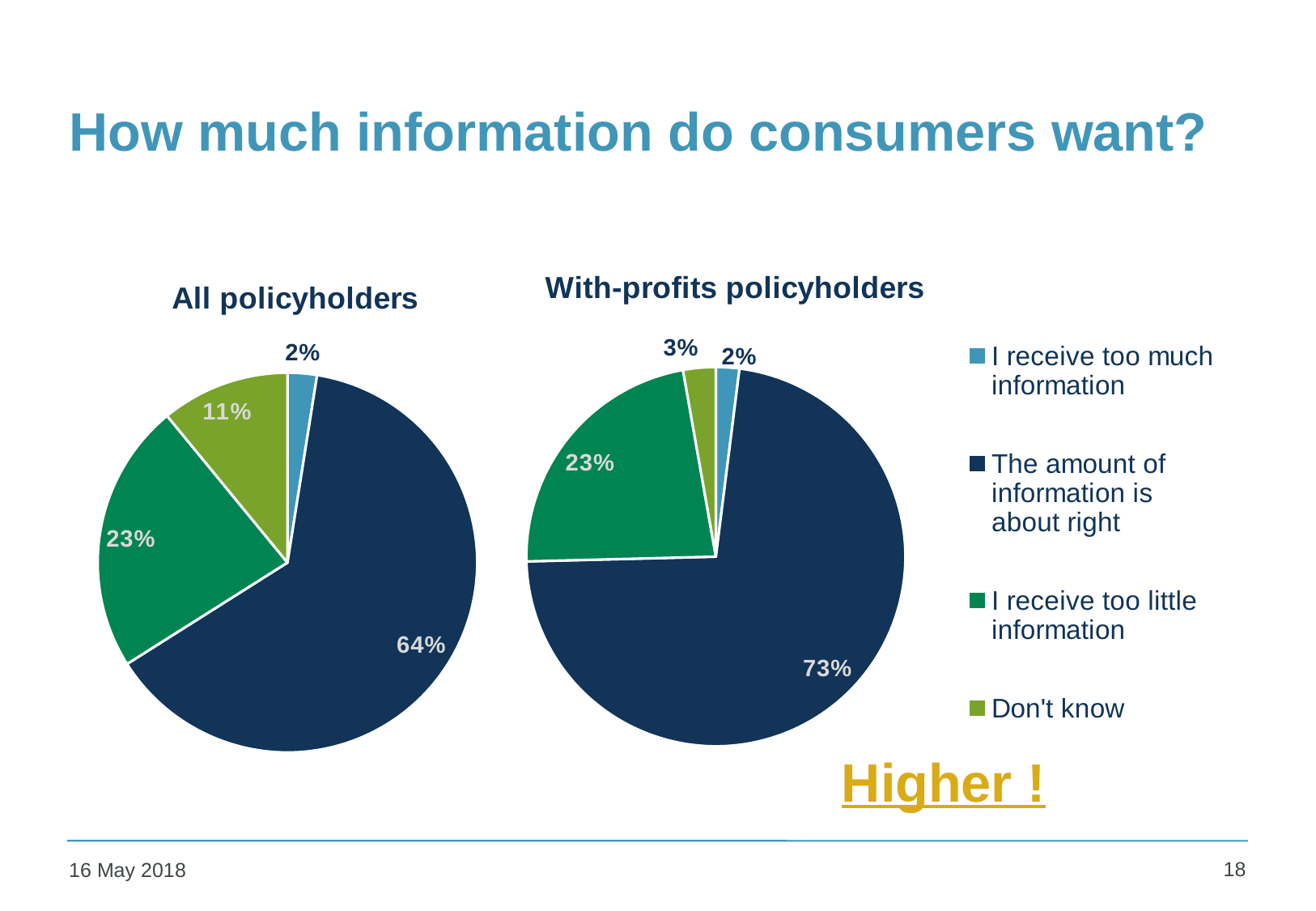
What type of chart is used on this slide? Pie chart In the 'All policyholders' chart, which category has the smallest slice? I receive too much information What is the difference between the 'about right' share in the 'With-profits policyholders' chart and the 'about right' share in the 'All policyholders' chart? 9 percentage points In the 'All policyholders' chart, what percentage say they receive too little information? 23% In the 'With-profits policyholders' chart, which category has the largest slice? The amount of information is about right How many categories does the legend list for the pie charts? 4 What is the title of the chart on the left? All policyholders In the 'With-profits policyholders' chart, what share of respondents say the amount of information is about right? 73% Which chart has the larger 'Don't know' share, 'All policyholders' or 'With-profits policyholders'? All policyholders In the 'All policyholders' chart, what share of respondents say the amount of information is about right? 64% In the 'With-profits policyholders' chart, what percentage answered 'Don't know'? 3% In the 'All policyholders' chart, what percentage answered 'Don't know'? 11%